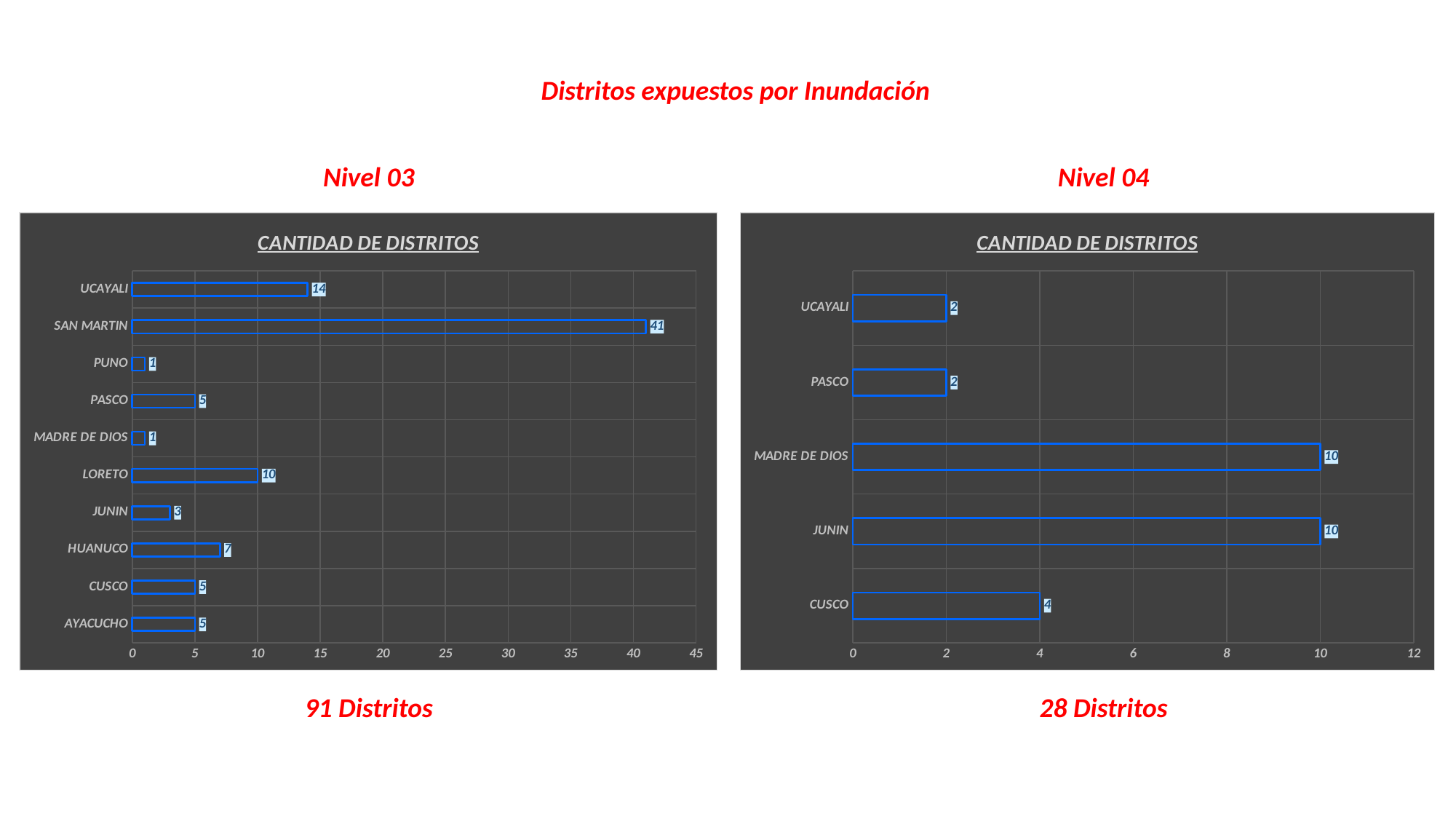
In the Nivel 03 chart, how many categories are plotted? 10 What kind of chart is the Nivel 04 chart? Bar chart In the Nivel 04 chart, which category has the lowest value, UCAYALI, PASCO or CUSCO? UCAYALI and PASCO (both 2) In the Nivel 04 chart, how many categories are plotted? 5 In the Nivel 04 chart, what is the value for CUSCO? 4 What is the title shown inside the Nivel 03 chart? CANTIDAD DE DISTRITOS In the Nivel 03 chart, which category has the highest value? SAN MARTIN In the Nivel 03 chart, which is larger, the value for LORETO or the value for JUNIN? LORETO In the Nivel 03 chart, what is the value for LORETO? 10 In the Nivel 03 chart, what is the value for SAN MARTIN? 41 In the Nivel 03 chart, what is the difference between the values for UCAYALI and HUANUCO? 7 In the Nivel 04 chart, what is the value for PASCO? 2